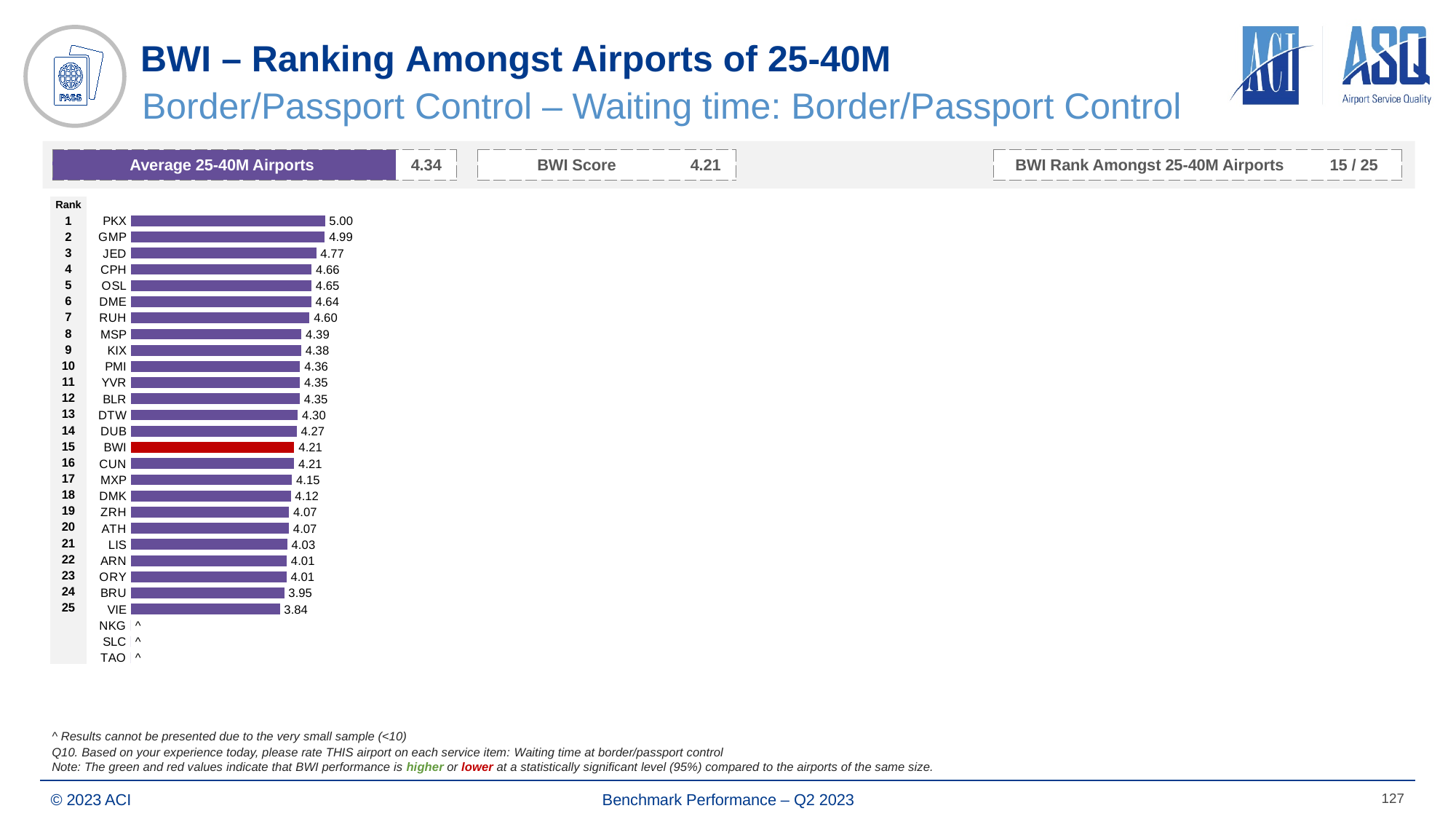
What is the difference between the scores of DUB and BRU? 0.32 Which airport's bar is coloured red in the chart? BWI What is the score for JED? 4.77 How many airports have a bar plotted with a score in the chart? 25 What is the score for BWI in the chart? 4.21 What is the difference between the scores of PKX and BWI? 0.79 What kind of chart is shown on the slide? Bar chart Which airport with a plotted bar has the lowest score? VIE Which airport has the highest score in the chart? PKX Which has a higher score, MSP or MXP? MSP Do the scores rise or fall going down the ranked list from rank 1 to rank 25? Fall What is the score for VIE? 3.84